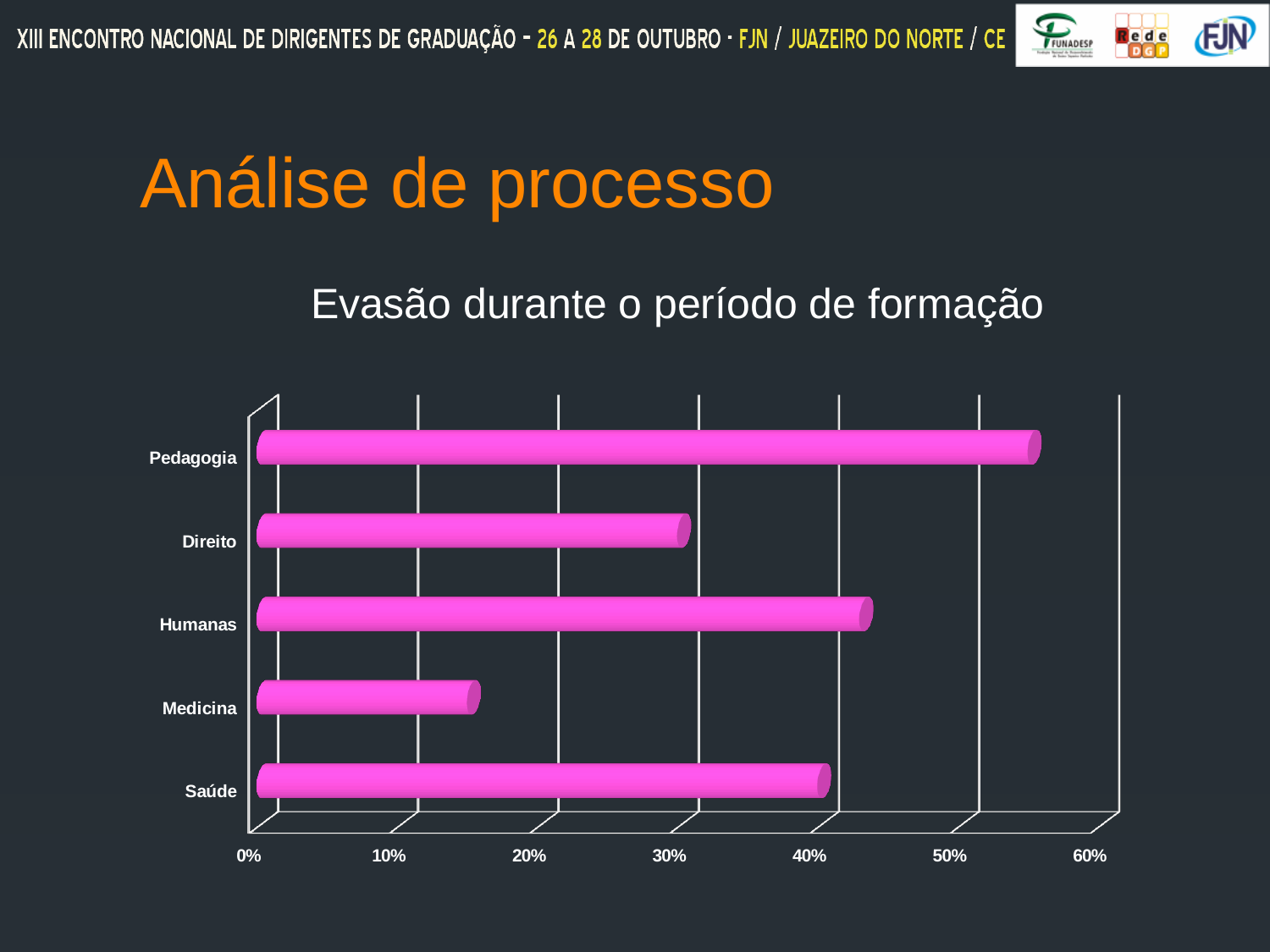
Which category has the highest evasion rate? Pedagogia Is the value for Saúde greater or less than 50%? less Which category has the lowest evasion rate? Medicina How many categories (courses) are shown in the chart? 5 Is the value for Direito greater or less than 40%? less Is the value for Pedagogia greater or less than 50%? greater Which has a higher evasion rate, Medicina or Direito? Direito Which has a higher evasion rate, Pedagogia or Direito? Pedagogia What kind of chart is shown on the slide? bar chart What is the title of the chart? Evasão durante o período de formação